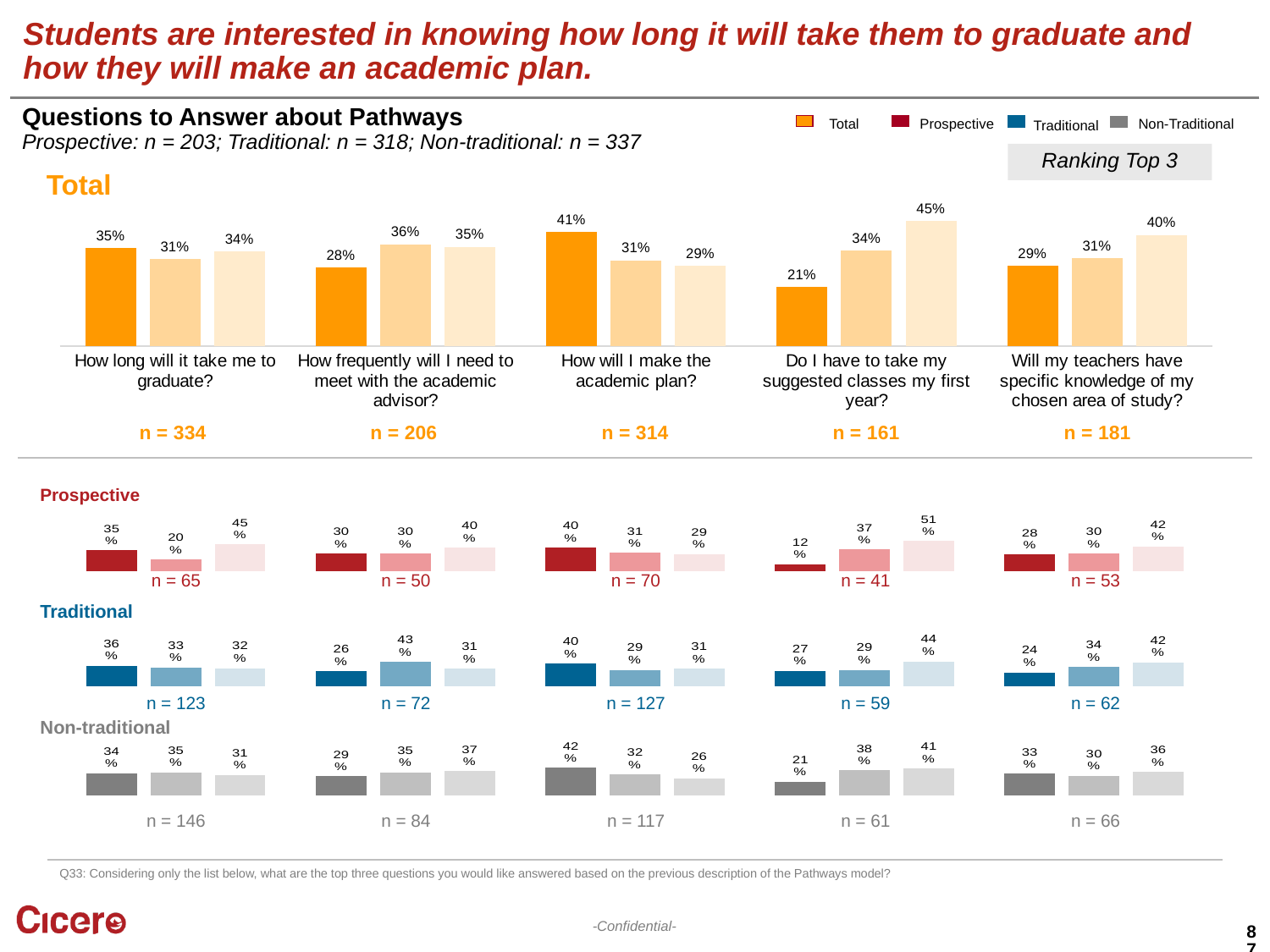
In the Total chart, what is the highest value shown across all bars? 45% In the Traditional chart, what is the value of the second (middle) bar for "How frequently will I need to meet with the academic advisor?" 43% What type of chart is used to show the Total results? Bar chart In the Non-traditional chart, what is the value of the first (darkest) bar for "How will I make the academic plan?" 42% In the Total chart, what is the difference between the third bar (45%) and the first bar (21%) for "Do I have to take my suggested classes my first year?" 24 percentage points How many question categories are shown along the x axis of the Total chart? 5 In the Total chart, which has the larger first (darkest) bar: "How long will it take me to graduate?" or "How frequently will I need to meet with the academic advisor?" How long will it take me to graduate? How many entries does the legend at the top right of the slide list? 4 In the Prospective chart, what is the lowest value shown? 12% In the Prospective chart, what is the highest value shown? 51% In the Total chart, what is the lowest value shown across all bars? 21% In the Total chart, what is the value of the first (darkest) bar for "How will I make the academic plan?" 41%